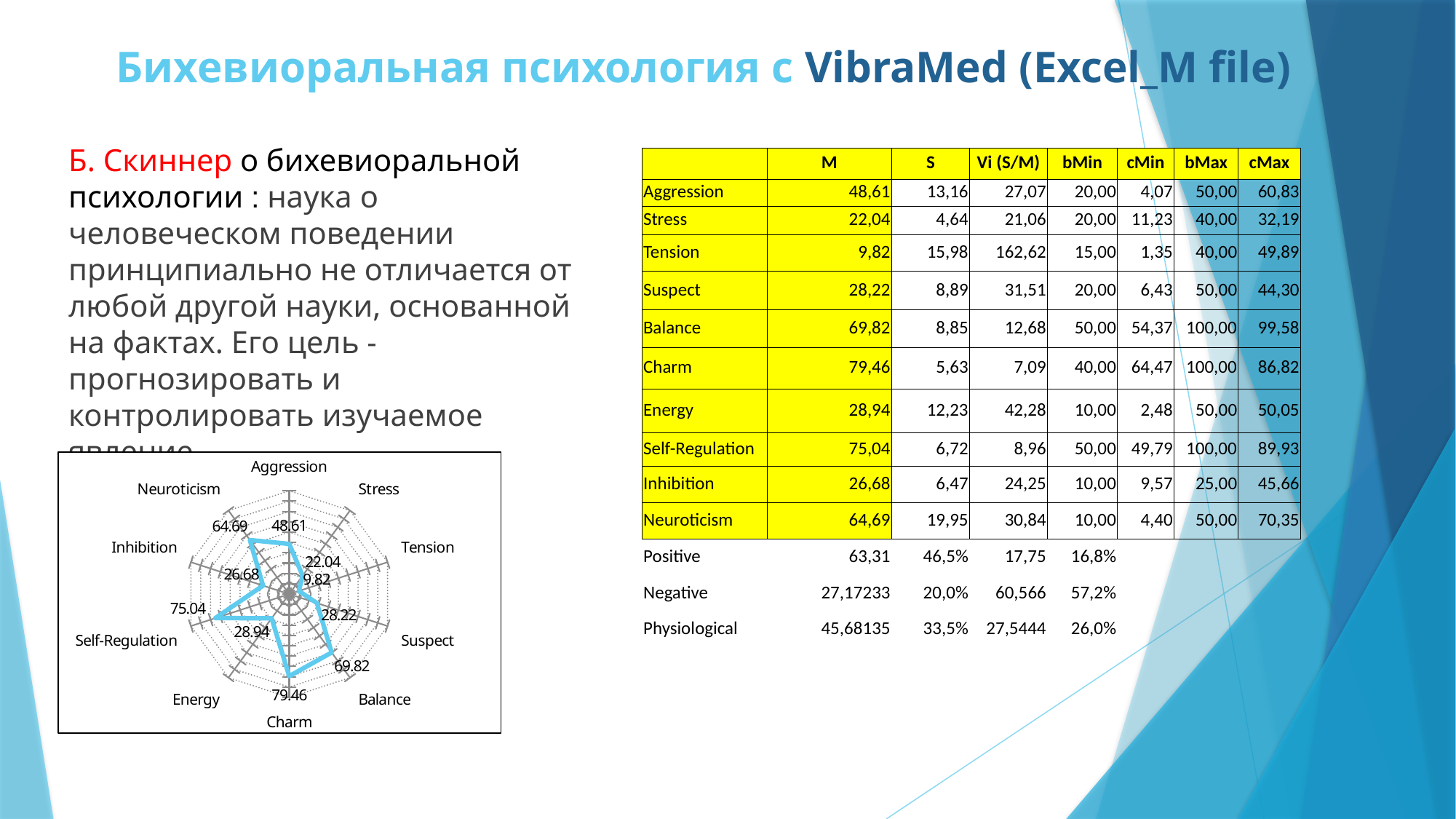
What is the value for Aggression on the radar chart? 48.61 What kind of chart is shown on the slide? radar chart What is the value for Charm on the radar chart? 79.46 What is the value for Tension on the radar chart? 9.82 What is the difference between the values for Energy and Inhibition on the radar chart? 2.26 Which category has the highest value on the radar chart? Charm Which category is plotted at the top of the radar chart? Aggression How many categories does the radar chart have? 10 Which category has the lowest value on the radar chart? Tension Which is larger on the radar chart, the value for Neuroticism or the value for Aggression? Neuroticism What is the value for Self-Regulation on the radar chart? 75.04 What is the difference between the values for Charm and Balance on the radar chart? 9.64